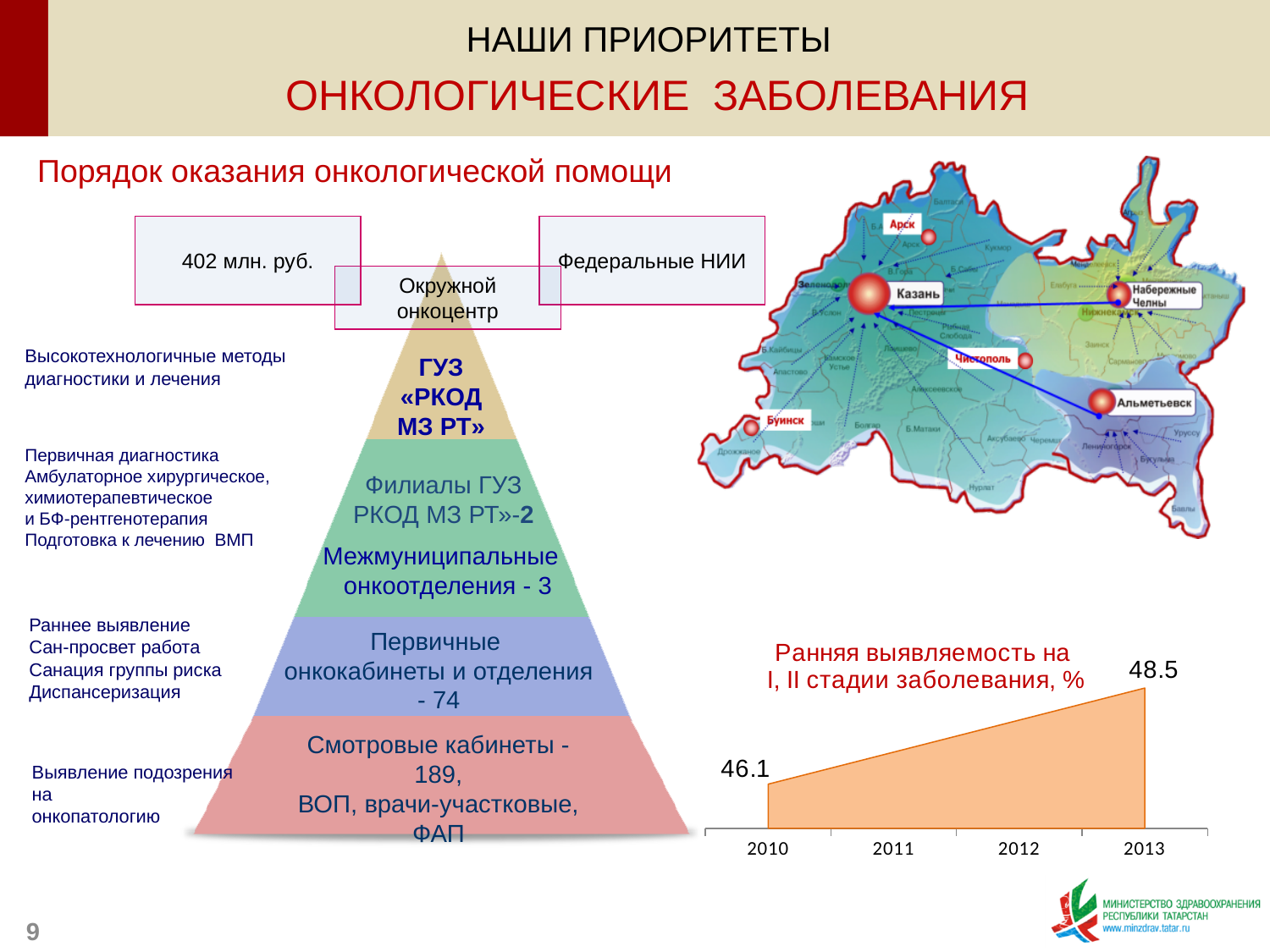
In the chart 'Ранняя выявляемость на I, II стадии заболевания, %', which year has the highest value? 2013 What kind of chart is used for 'Ранняя выявляемость на I, II стадии заболевания, %'? area chart How many years are shown on the x axis of the chart 'Ранняя выявляемость на I, II стадии заболевания, %'? 4 What is the value shown for 2013 in the chart 'Ранняя выявляемость на I, II стадии заболевания, %'? 48.5 What is the first year shown on the x axis of the chart 'Ранняя выявляемость на I, II стадии заболевания, %'? 2010 What colour is the filled area in the chart 'Ранняя выявляемость на I, II стадии заболевания, %'? orange In the chart 'Ранняя выявляемость на I, II стадии заболевания, %', by how much does the 2013 value exceed the 2010 value? 2.4 What is the value shown for 2010 in the chart 'Ранняя выявляемость на I, II стадии заболевания, %'? 46.1 What is the title of the chart in the bottom right of the slide? Ранняя выявляемость на I, II стадии заболевания, % In the chart 'Ранняя выявляемость на I, II стадии заболевания, %', which year has the larger value, 2010 or 2013? 2013 In the chart 'Ранняя выявляемость на I, II стадии заболевания, %', which year has the lowest value? 2010 Do the values in the chart 'Ранняя выявляемость на I, II стадии заболевания, %' rise or fall from 2010 to 2013? rise